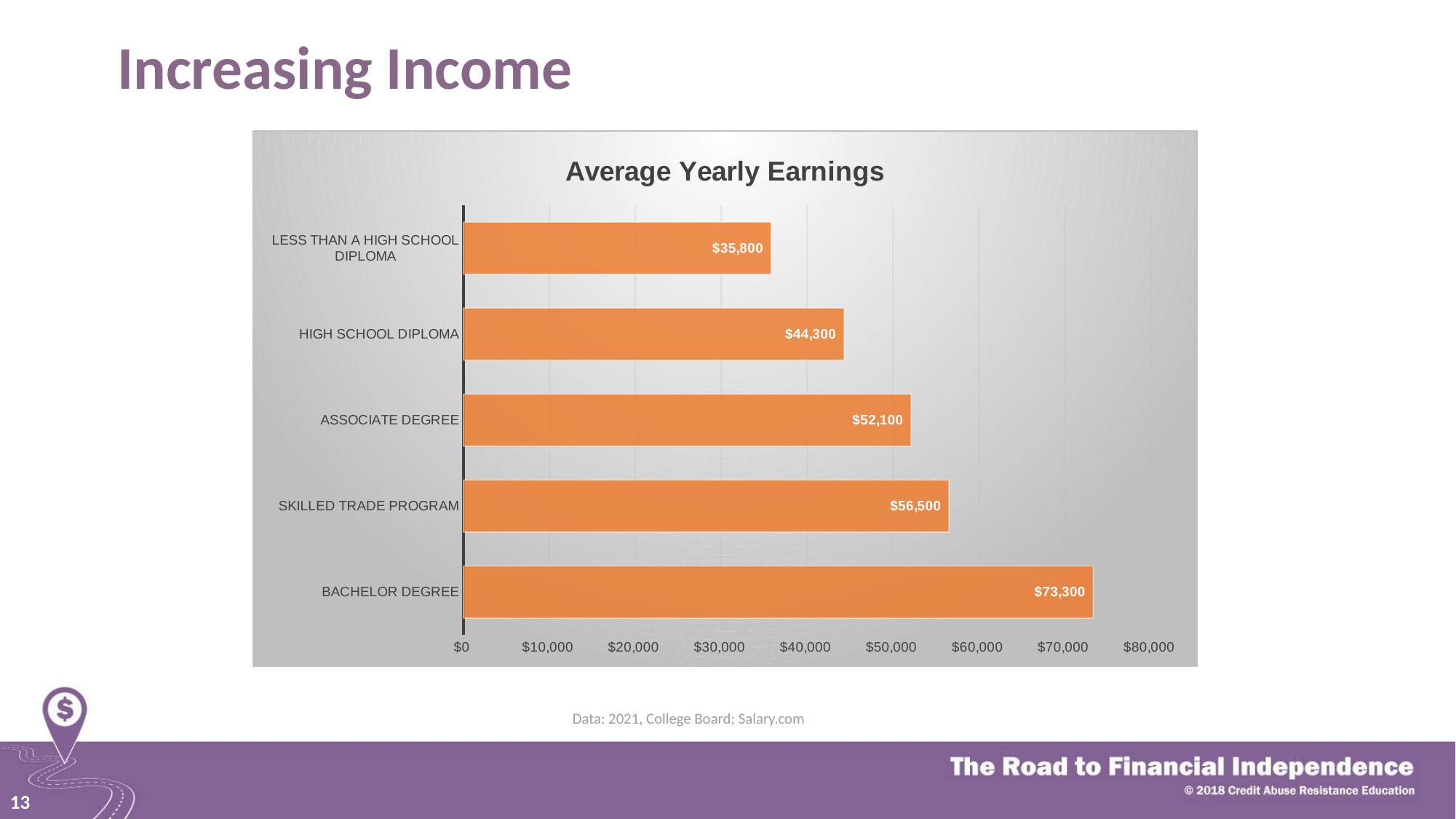
Which category has the highest average yearly earnings? Bachelor Degree What is the difference in average yearly earnings between a Bachelor Degree and an Associate Degree? $21,200 How many education categories are shown in the chart? 5 What is the average yearly earnings for a Bachelor Degree? $73,300 What is the average yearly earnings for a High School Diploma? $44,300 Is the value for Associate Degree greater or less than $50,000? greater What is the title of the chart? Average Yearly Earnings Which category has the lowest average yearly earnings? Less Than a High School Diploma What is the average yearly earnings for a Skilled Trade Program? $56,500 What is the difference in average yearly earnings between a High School Diploma and Less Than a High School Diploma? $8,500 What kind of chart is shown on the slide? Bar chart Which has higher average yearly earnings, a Skilled Trade Program or an Associate Degree? Skilled Trade Program